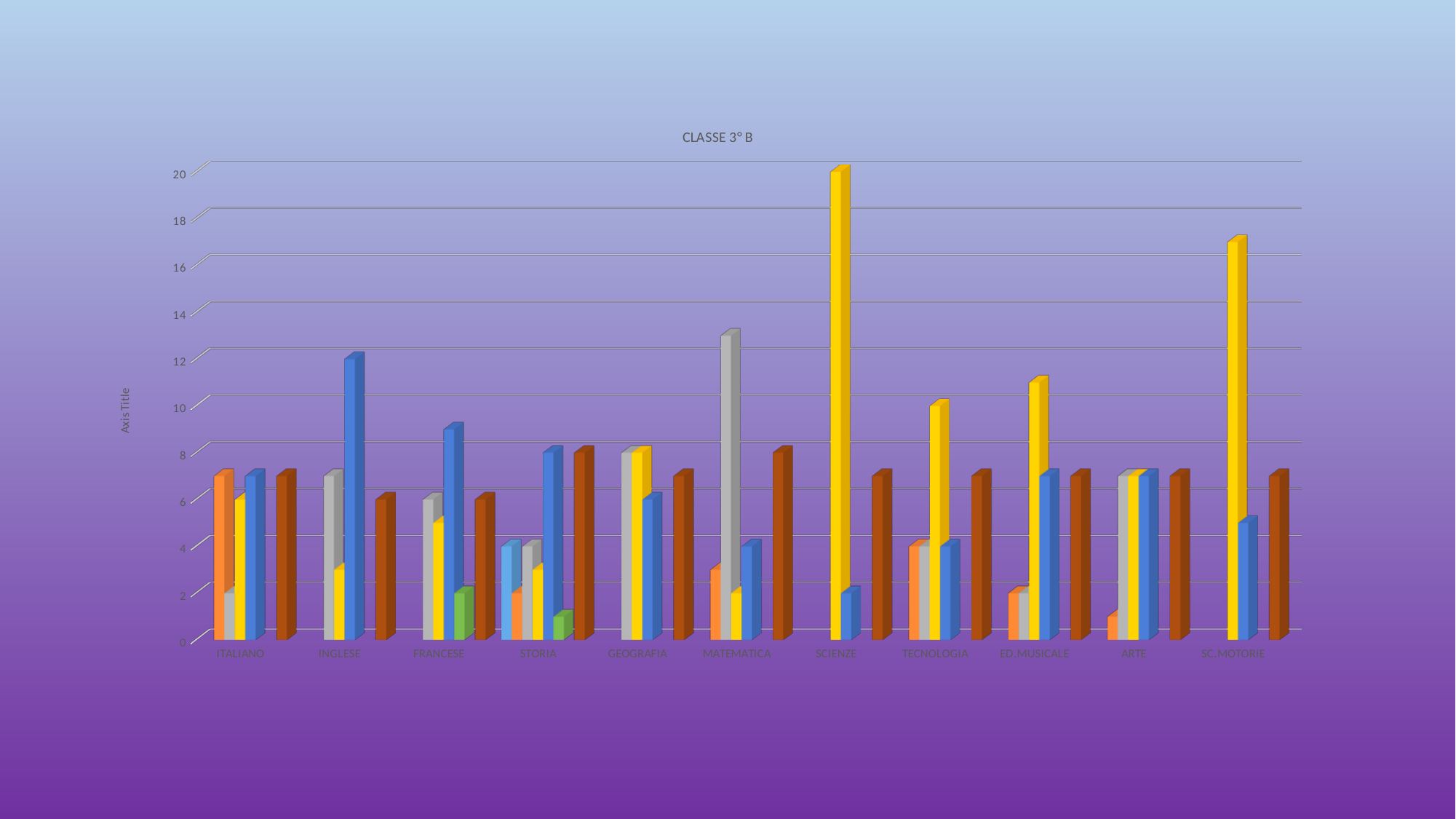
Which has the larger yellow bar, SCIENZE or SC.MOTORIE? SCIENZE What is the title of the chart? CLASSE 3° B What is the label on the vertical axis of the chart? Axis Title Is the value of the green bar for FRANCESE greater or less than 4? less Is the value of the gray bar for MATEMATICA greater or less than 12? greater What kind of chart is shown on the slide? bar chart Which has the larger blue bar, INGLESE or FRANCESE? INGLESE Which category contains the tallest bar in the chart? SCIENZE Is the value of the blue bar for INGLESE greater or less than 10? greater How many categories are shown along the x axis of the chart? 11